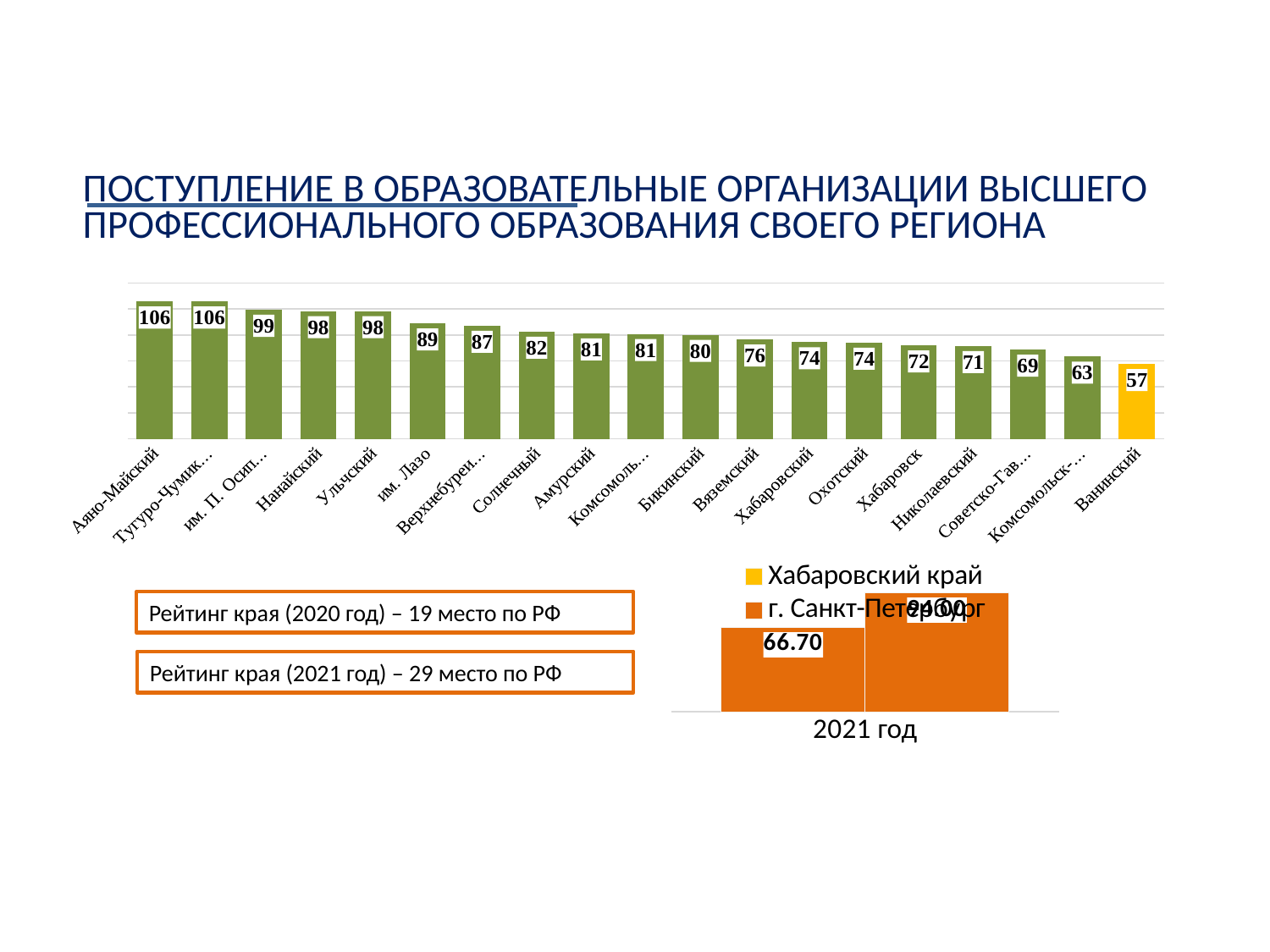
In the top bar chart, what is the value for Бикинский? 80 What kind of chart is the top chart on the slide? bar chart How many series does the legend of the bottom-right chart list? 2 In the top bar chart, what is the difference between the values for Аяно-Майский and Ванинский? 49 In the top bar chart, what is the value for Ванинский? 57 In the top bar chart, what is the value for Нанайский? 98 In the top bar chart, how many categories are plotted? 19 In the top bar chart, which is larger, the value for им. Лазо or the value for Солнечный? им. Лазо In the top bar chart, which category has the lowest value? Ванинский In the top bar chart, do the values rise or fall from left to right? fall In the top bar chart, what is the value for Охотский? 74